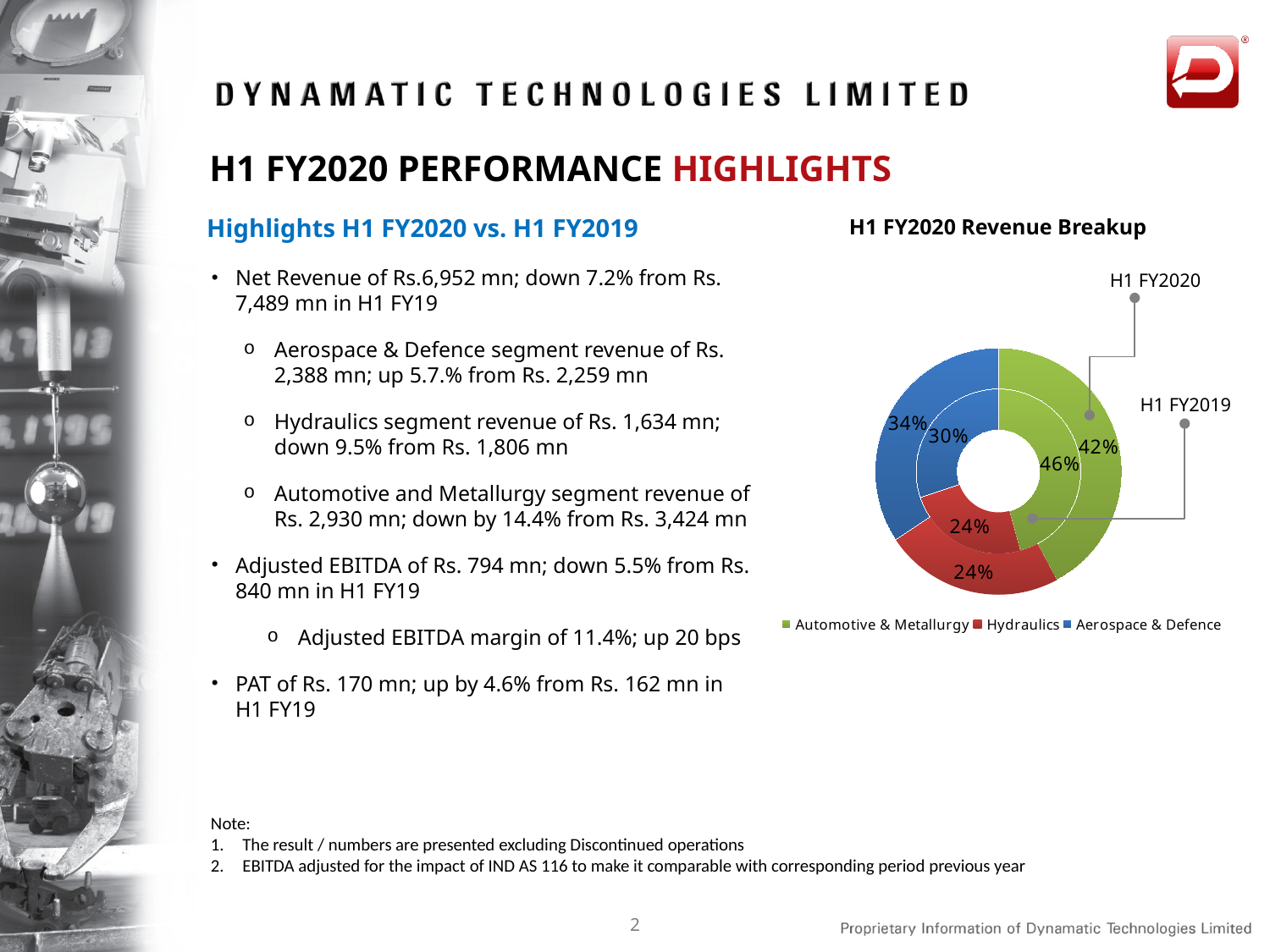
In the H1 FY2020 Revenue Breakup chart, which segment has the smallest share in H1 FY2019? Hydraulics In the H1 FY2020 Revenue Breakup chart, what share of revenue does Automotive & Metallurgy account for in H1 FY2020 (outer ring)? 42% In the H1 FY2020 Revenue Breakup chart, which colour represents Hydraulics? Red In the H1 FY2020 Revenue Breakup chart, what share of revenue does Aerospace & Defence account for in H1 FY2019 (inner ring)? 30% How many segments does the legend of the H1 FY2020 Revenue Breakup chart list? 3 What kind of chart is shown under the title 'H1 FY2020 Revenue Breakup'? Doughnut chart In the H1 FY2020 Revenue Breakup chart, is the Aerospace & Defence share larger in H1 FY2020 or in H1 FY2019? H1 FY2020 In the H1 FY2020 Revenue Breakup chart, what share of revenue does Hydraulics account for in H1 FY2020 (outer ring)? 24% In the H1 FY2020 Revenue Breakup chart, what share of revenue does Automotive & Metallurgy account for in H1 FY2019 (inner ring)? 46% In the H1 FY2020 Revenue Breakup chart, what is the difference between the Automotive & Metallurgy share in H1 FY2019 and in H1 FY2020? 4 percentage points In the H1 FY2020 Revenue Breakup chart, which segment has the largest share in H1 FY2020? Automotive & Metallurgy In the H1 FY2020 Revenue Breakup chart, what share of revenue does Aerospace & Defence account for in H1 FY2020 (outer ring)? 34%